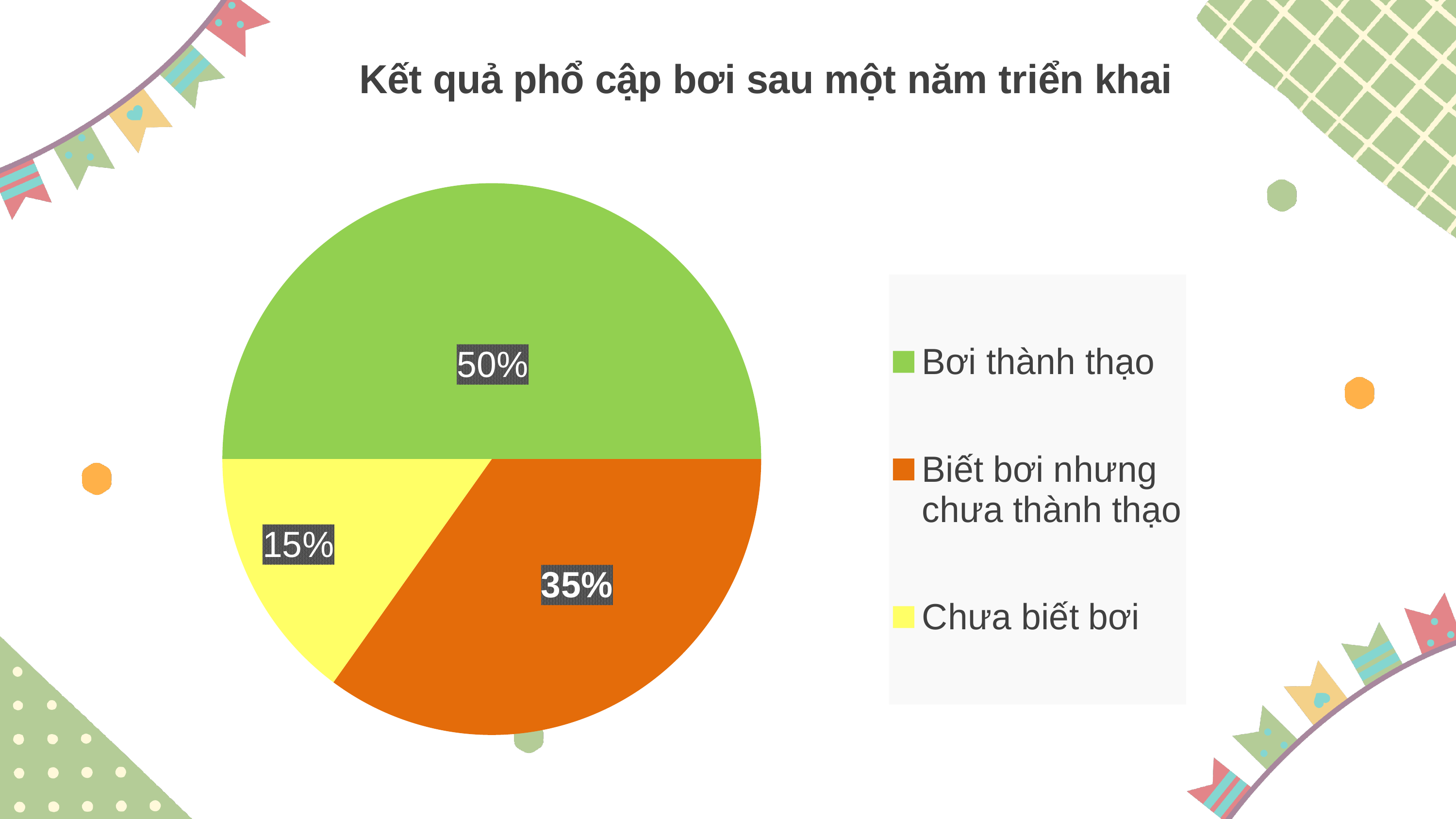
Which category has the largest share of the pie? Bơi thành thạo What is the title of the chart? Kết quả phổ cập bơi sau một năm triển khai What percentage is shown for "Biết bơi nhưng chưa thành thạo"? 35% What colour represents "Chưa biết bơi" in the legend? Yellow What percentage is shown for "Chưa biết bơi"? 15% What type of chart is shown on the slide? Pie chart What is the difference in percentage points between "Bơi thành thạo" and "Chưa biết bơi"? 35% Which is larger: the share for "Biết bơi nhưng chưa thành thạo" or the share for "Chưa biết bơi"? Biết bơi nhưng chưa thành thạo How many categories does the pie chart have? 3 Which category has the smallest share of the pie? Chưa biết bơi What percentage is shown for "Bơi thành thạo"? 50% What is the difference in percentage points between "Biết bơi nhưng chưa thành thạo" and "Chưa biết bơi"? 20%